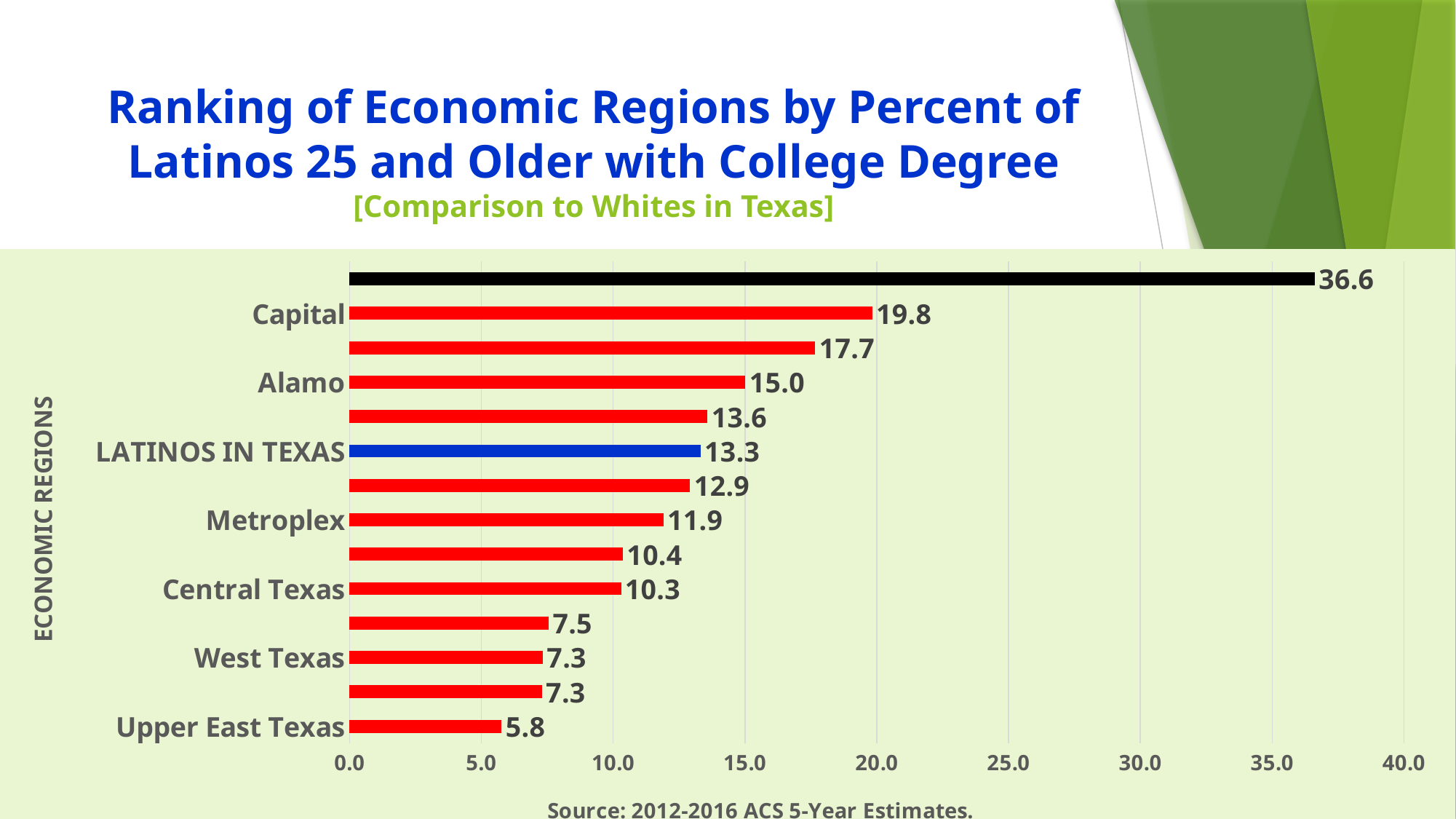
How many bars are plotted on the chart? 14 What is the value for LATINOS IN TEXAS? 13.3 What is the value of the longest bar on the chart? 36.6 Which labeled region has the lowest value? Upper East Texas What is the value for Capital? 19.8 What is the value for Metroplex? 11.9 What is the title of the vertical axis? ECONOMIC REGIONS Is the value for Central Texas greater or less than 15.0? less What is the value for Upper East Texas? 5.8 What kind of chart is shown on the slide? Bar chart Which is larger, the value for Alamo or the value for Metroplex? Alamo What is the difference between the values for Capital and Alamo? 4.8